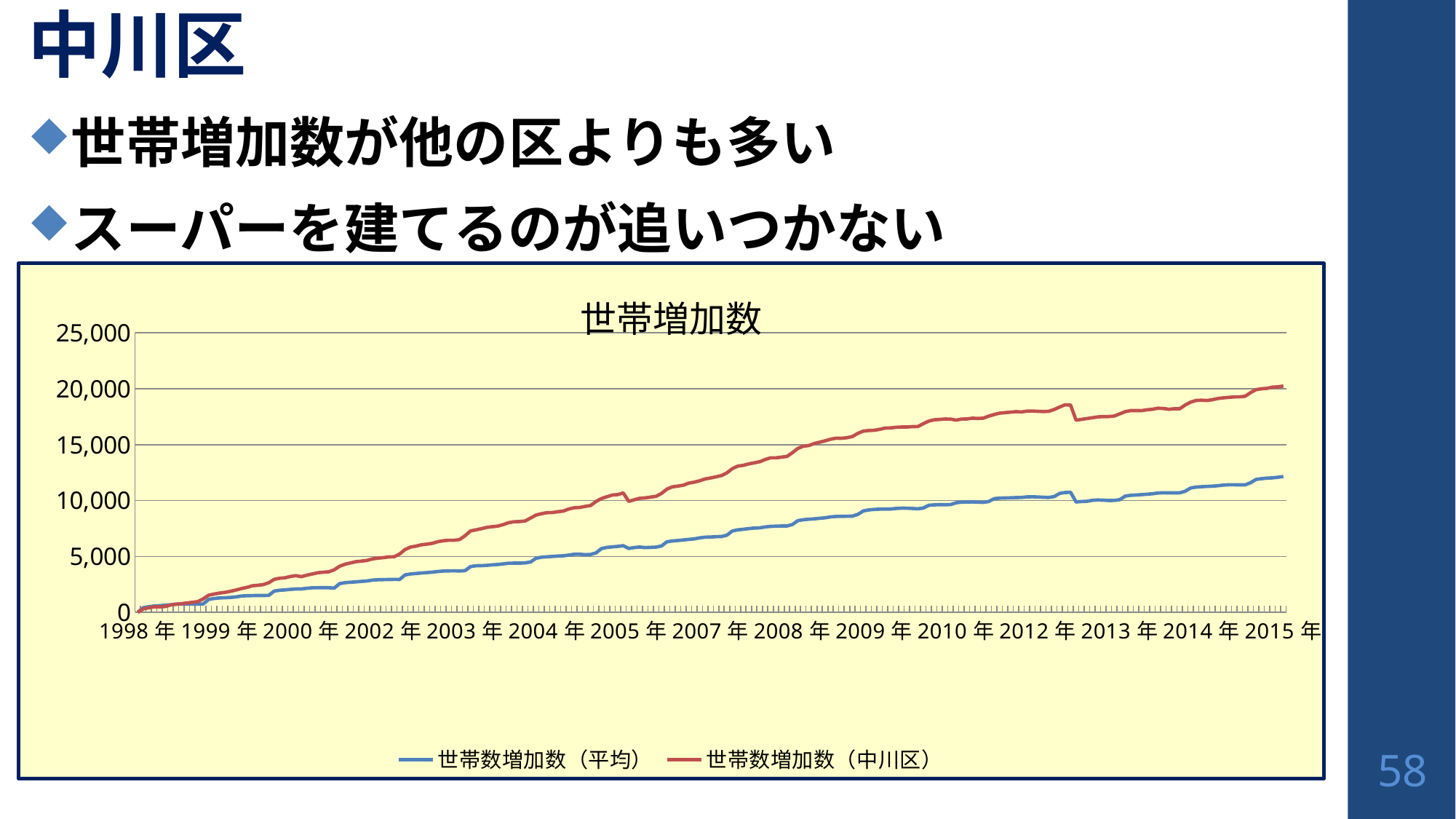
Do the values for 世帯数増加数（平均） generally rise or fall from 1998 年 to 2015 年? rise What kind of chart is shown on the slide? line chart How many series does the chart legend list? 2 Is the value for 世帯数増加数（中川区） at 2008 年 greater or less than 10,000? greater Which series is drawn in red? 世帯数増加数（中川区） Is the value for 世帯数増加数（中川区） at 2015 年 greater or less than 15,000? greater Which series is higher at 2015 年, 世帯数増加数（平均） or 世帯数増加数（中川区）? 世帯数増加数（中川区） Is the value for 世帯数増加数（平均） at 2008 年 greater or less than 10,000? less Do the values for 世帯数増加数（中川区） generally rise or fall from 1998 年 to 2015 年? rise What is the title of the chart? 世帯増加数 What is the highest value shown on the vertical axis? 25,000